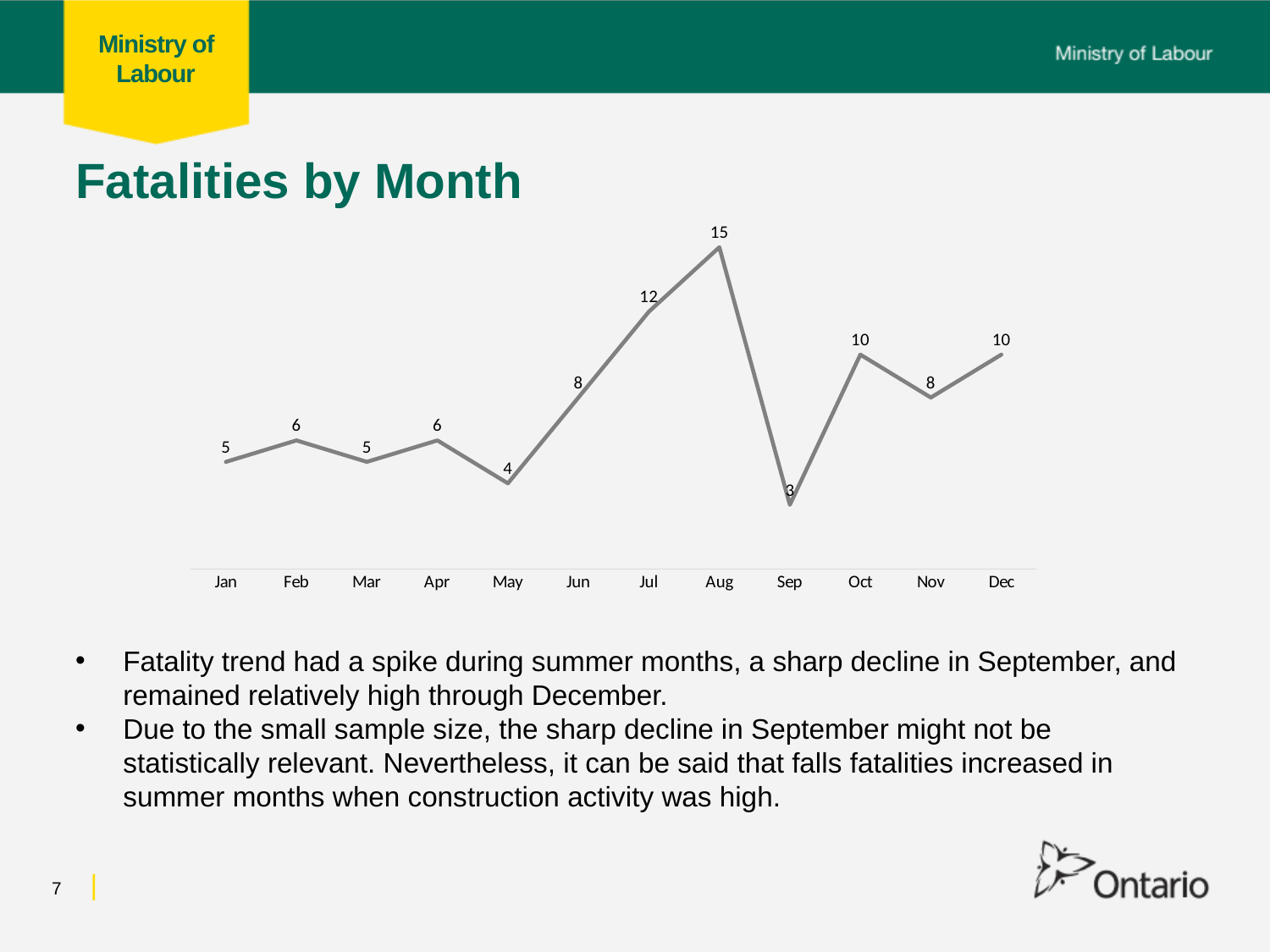
How many months are plotted on the chart? 12 Which is larger, the value for Oct or the value for Nov? Oct What is the title of the chart? Fatalities by Month What is the difference between the values for Aug and Sep? 12 What is the value for Aug? 15 What kind of chart is shown? Line chart What is the value for May? 4 Which month has the lowest value? Sep Which month has the highest value? Aug What is the value for Sep? 3 What is the difference between the values for Jul and Jun? 4 Do the values rise or fall from May to Aug? Rise